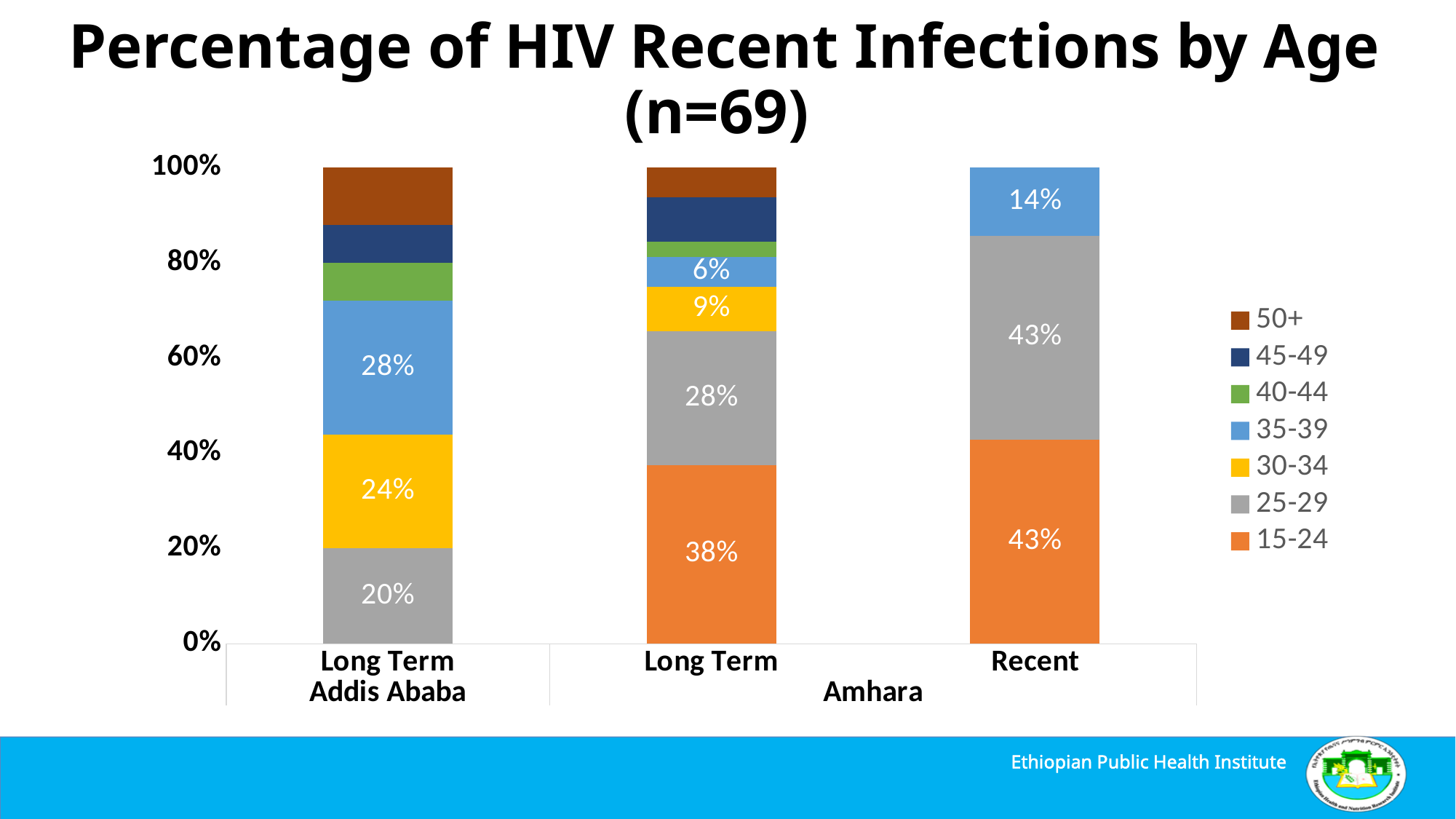
How many age groups does the legend list? 7 What is the difference between the 25-29 share in the Amhara Long Term bar and the 25-29 share in the Addis Ababa Long Term bar? 8 percentage points What percentage of the Long Term bar for Amhara is the 30-34 age group? 9% What percentage of the Long Term bar for Amhara is the 15-24 age group? 38% What percentage of the Recent bar for Amhara is the 35-39 age group? 14% How many bars are plotted in the chart? 3 What percentage of the Long Term bar for Addis Ababa is the 35-39 age group? 28% By how many percentage points does the 15-24 share in the Amhara Recent bar exceed the 15-24 share in the Amhara Long Term bar? 5 percentage points What kind of chart is shown on the slide? Stacked bar chart Which bar has the larger 30-34 share: Long Term Addis Ababa or Long Term Amhara? Long Term Addis Ababa Which age group is listed first (at the top) in the legend? 50+ What percentage of the Recent bar for Amhara is the 25-29 age group? 43%